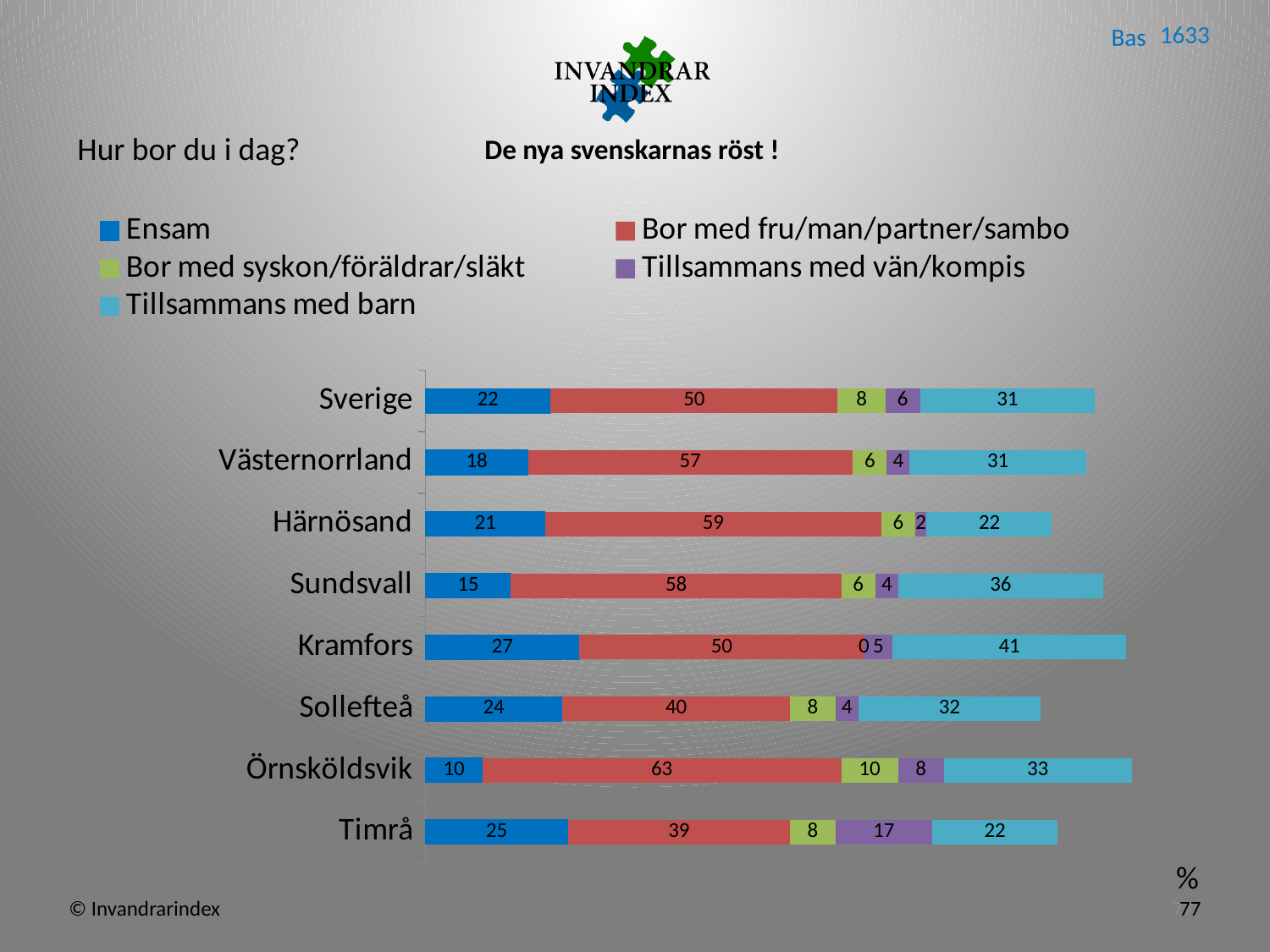
How many categories are shown on the chart? 8 What is the value for Tillsammans med barn for Sundsvall? 36 What kind of chart is shown on the slide? Stacked bar chart Which category has the highest value for Tillsammans med barn? Kramfors Which is larger, the Ensam value for Sverige or for Västernorrland? Sverige What is the value for Bor med fru/man/partner/sambo for Örnsköldsvik? 63 How many series does the legend list? 5 What is the value for Tillsammans med vän/kompis for Timrå? 17 What is the difference between the Bor med fru/man/partner/sambo values for Örnsköldsvik and Timrå? 24 Which category has the highest value for Ensam? Kramfors Which category has the lowest value for Ensam? Örnsköldsvik What is the value for Ensam for Kramfors? 27